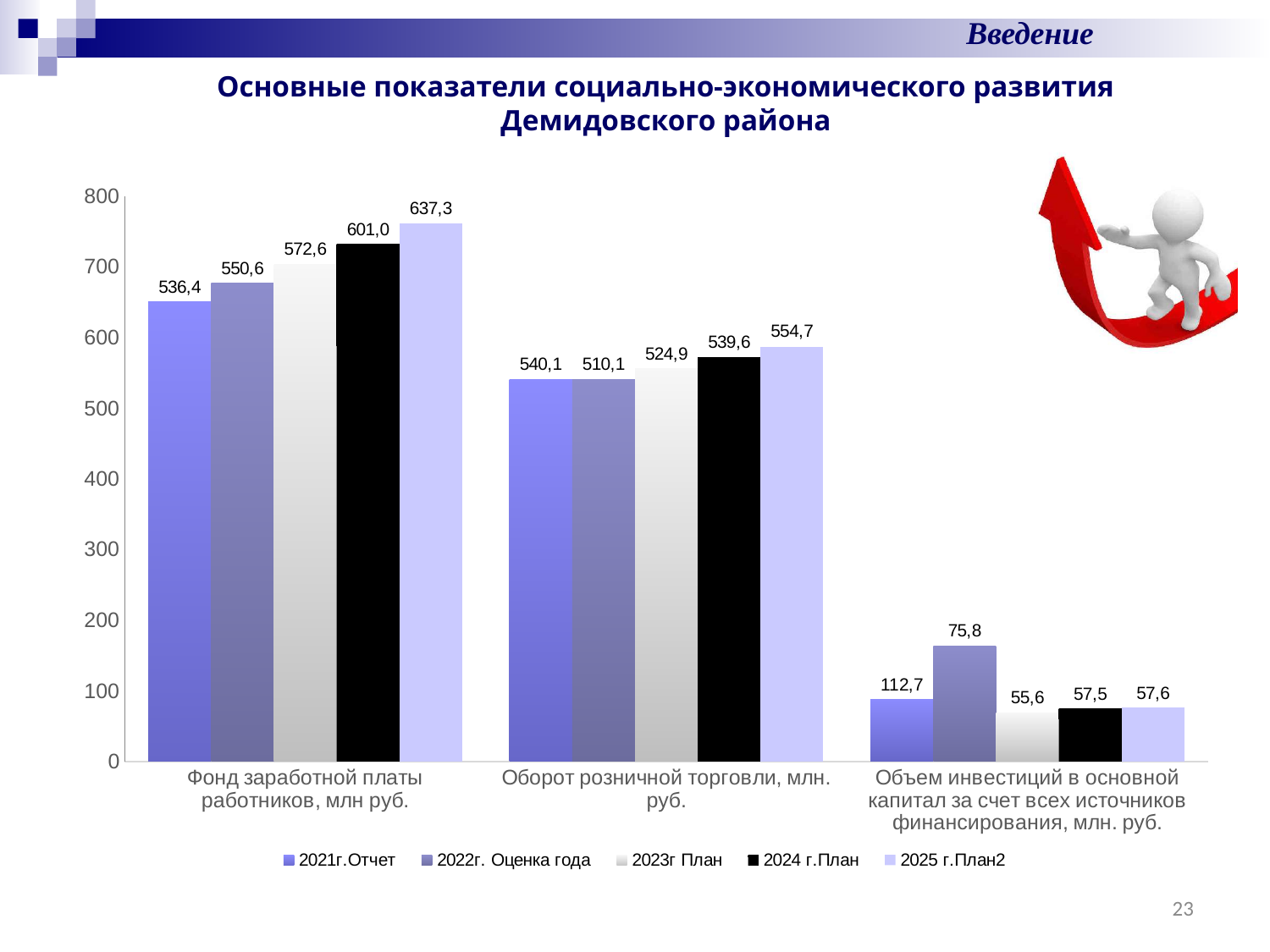
What kind of chart is shown on the slide? Bar chart Which series has the lowest value in the category Объем инвестиций в основной капитал за счет всех источников финансирования, млн. руб.? 2023г План What is the value for 2022г. Оценка года in the category Объем инвестиций в основной капитал за счет всех источников финансирования, млн. руб.? 75,8 In the category Оборот розничной торговли, млн. руб., which is larger: the 2021г.Отчет value or the 2022г. Оценка года value? 2021г.Отчет How many categories are shown on the x axis of the chart? 3 Do the values for Фонд заработной платы работников, млн руб. rise or fall from 2021г.Отчет to 2025 г.План2? Rise What is the value for 2025 г.План2 in the category Оборот розничной торговли, млн. руб.? 554,7 Which series has the highest value in the category Фонд заработной платы работников, млн руб.? 2025 г.План2 How many series does the legend list? 5 What is the difference between the 2021г.Отчет and 2025 г.План2 values for Объем инвестиций в основной капитал за счет всех источников финансирования, млн. руб.? 55,1 What is the difference between the 2025 г.План2 and 2021г.Отчет values for Фонд заработной платы работников, млн руб.? 100,9 What is the value for 2024 г.План in the category Фонд заработной платы работников, млн руб.? 601,0